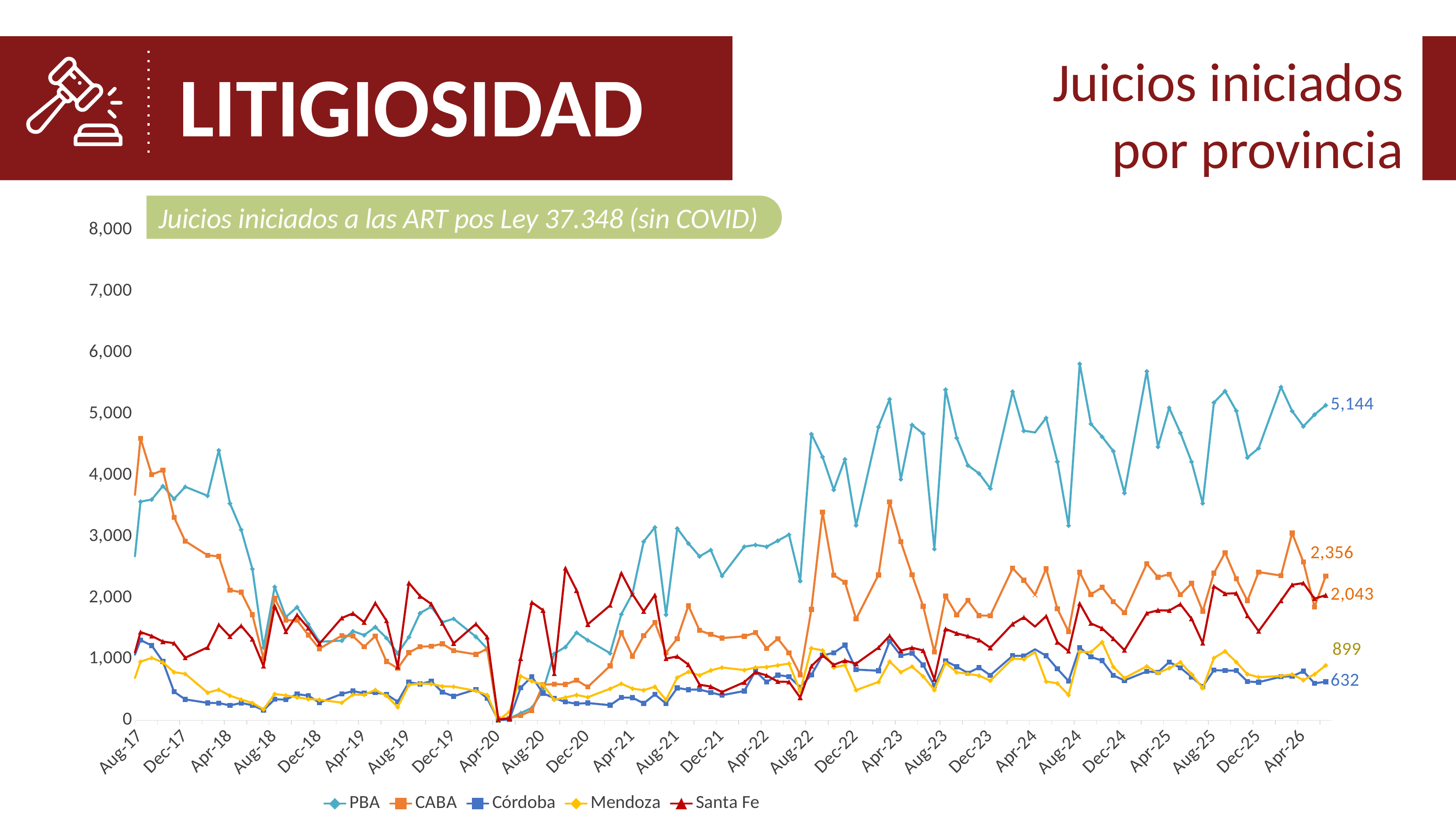
What is the final labelled value for the PBA series? 5,144 Is the final labelled value for CABA greater or less than the final labelled value for Santa Fe? greater Which series has the highest final labelled value? PBA What is the title of the chart? Juicios iniciados a las ART pos Ley 37.348 (sin COVID) What is the difference between the final labelled values of PBA and CABA? 2,788 What is the final labelled value for the Córdoba series? 632 What is the final labelled value for the CABA series? 2,356 Which series has the lowest final labelled value? Córdoba What type of chart is shown on the slide? line chart How many series does the legend list? 5 What is the final labelled value for the Mendoza series? 899 What is the final labelled value for the Santa Fe series? 2,043